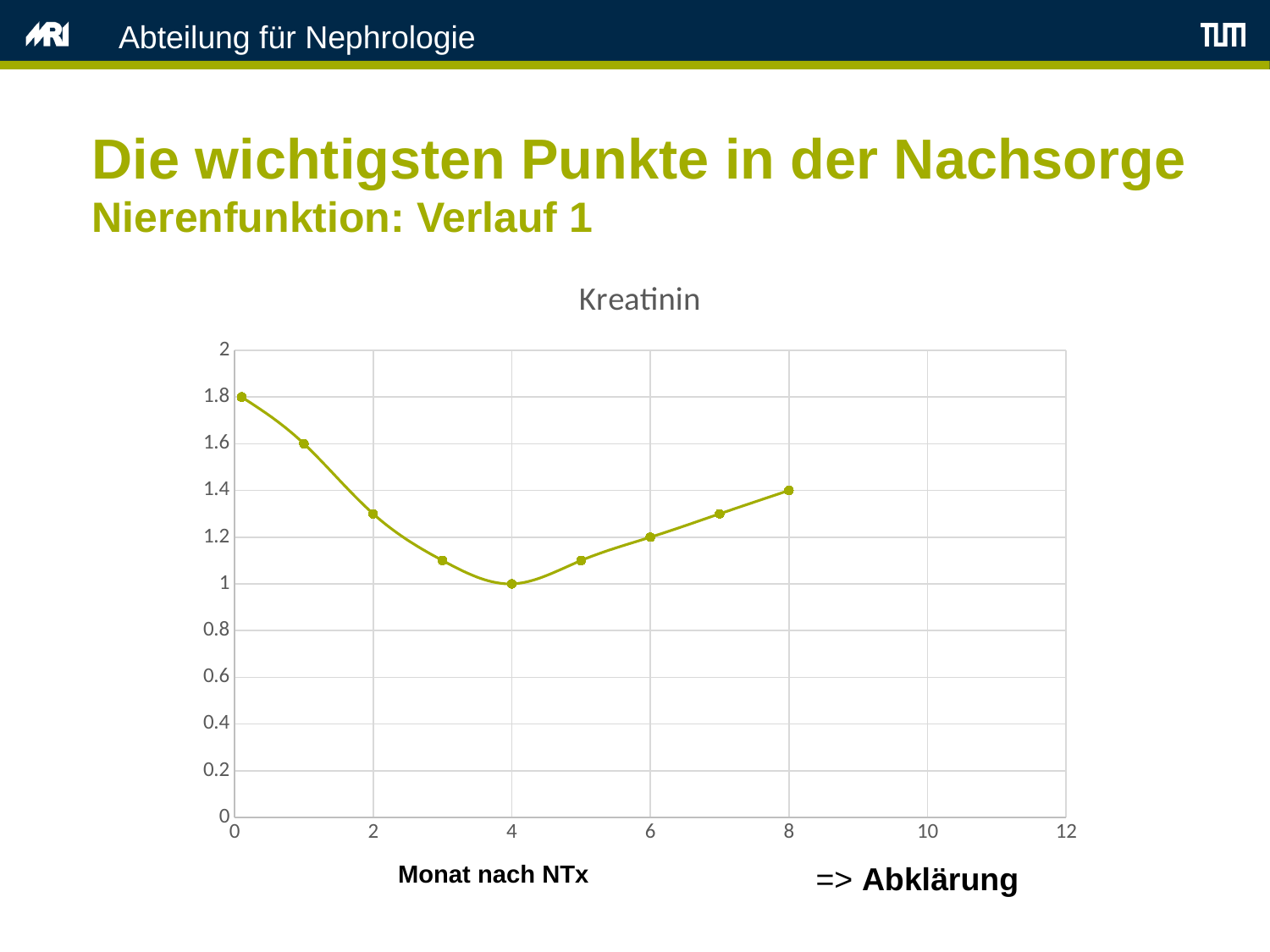
Is the Kreatinin value at month 2 greater or less than 1.2? greater What is the Kreatinin value at month 0? 1.8 At which month is the Kreatinin value highest? 0 How many data points are plotted on the chart? 9 Which is larger, the Kreatinin value at month 1 or at month 6? month 1 At which month is the Kreatinin value lowest? 4 What is the Kreatinin value at month 4? 1 What kind of chart is shown on the slide? line chart What is the title of the chart? Kreatinin What is the difference between the Kreatinin value at month 0 and at month 8? 0.4 What is the Kreatinin value at month 8? 1.4 What is the x-axis label of the chart? Monat nach NTx